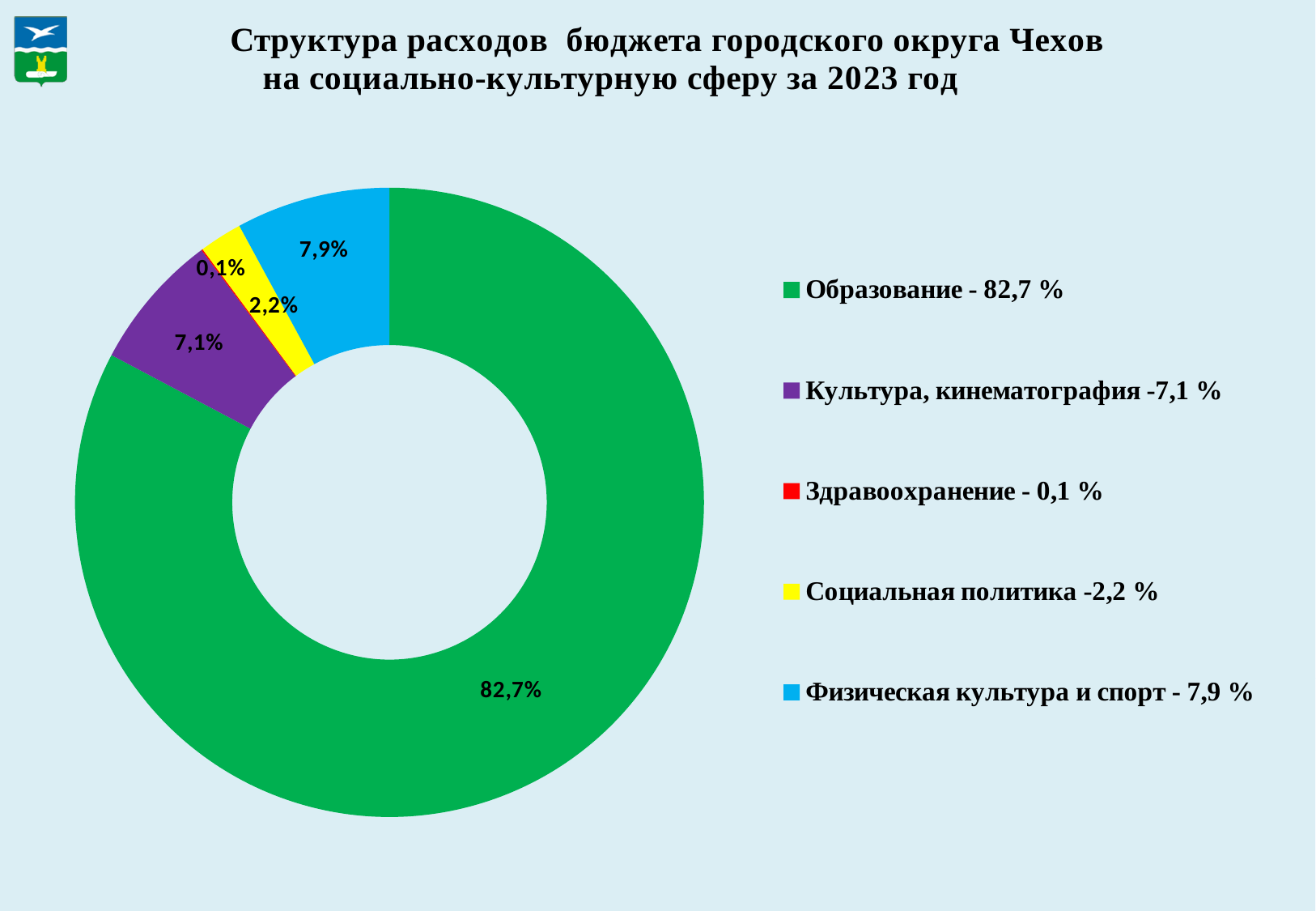
How many categories are shown in the chart? 5 What colour is the slice for Социальная политика? Yellow What is the value shown for Социальная политика? 2,2% Which category has the smallest share of the chart? Здравоохранение Which is larger: the share of Физическая культура и спорт or the share of Культура, кинематография? Физическая культура и спорт Which category has the largest share of the chart? Образование What is the value shown for Культура, кинематография? 7,1% What share of the budget expenditure goes to Образование? 82,7% What kind of chart is shown on the slide? Pie chart (doughnut) What is the difference between the shares of Образование and Физическая культура и спорт? 74,8% What is the value shown for Физическая культура и спорт? 7,9% What year does the chart title refer to? 2023